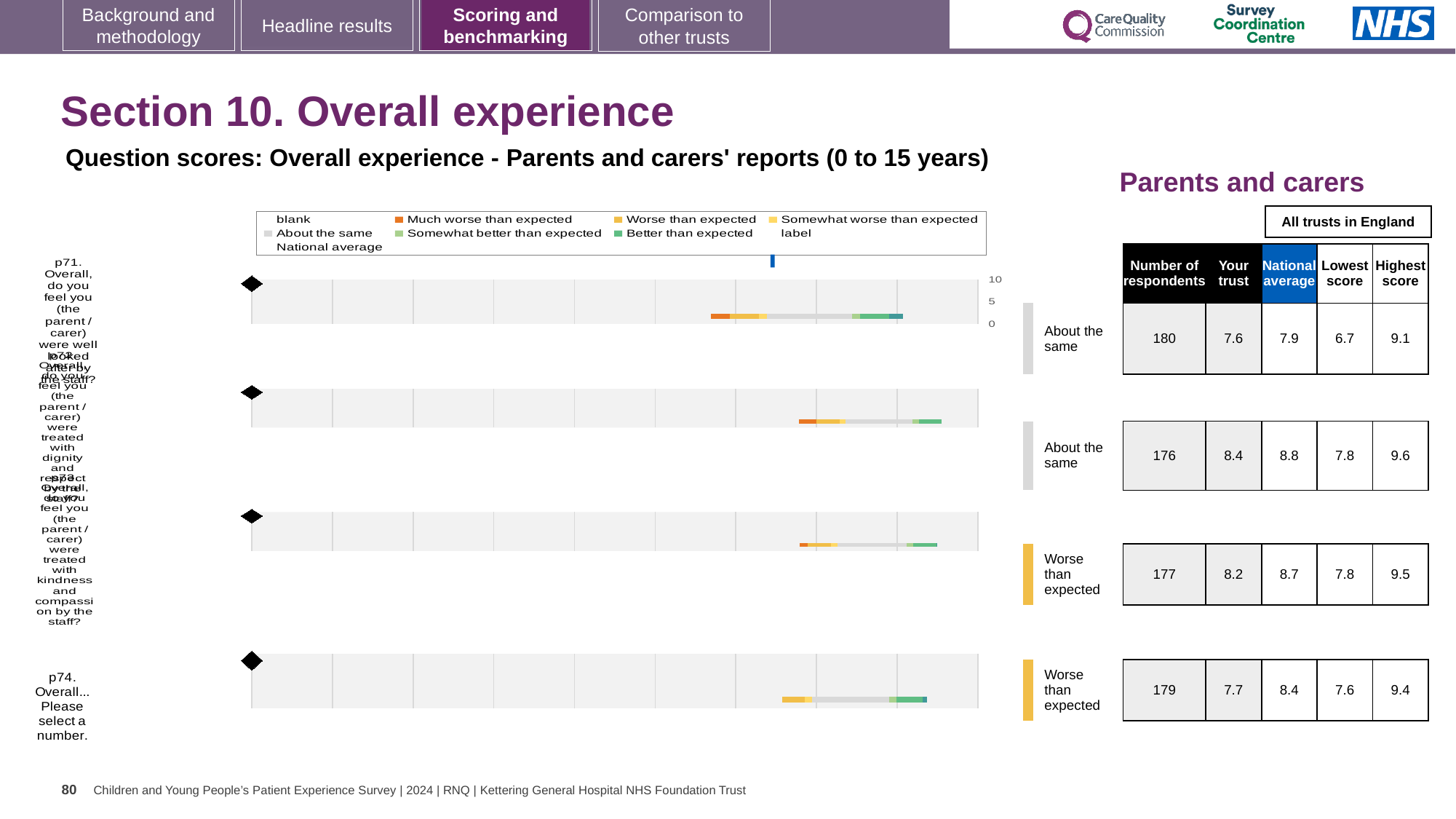
In the table beside the chart, which is larger for p72: the 'Your trust' score or the national average? National average In the table beside the chart, what is the 'Your trust' score for p71 (overall, were you well looked after by the staff)? 7.6 In the table beside the chart, which question has the lowest 'Your trust' score? p71 How many entries does the chart legend list? 9 In the table beside the chart, what is the difference between the national average and the 'Your trust' score for p74? 0.7 What colour does the legend use for 'Much worse than expected'? orange What kind of chart is shown on the slide? bar chart In the table beside the chart, which question has the highest 'Your trust' score? p72 How many question bars (p71 to p74) are plotted in the chart? 4 What benchmark category label is shown next to the p74 bar? Worse than expected In the table beside the chart, what is the national average for p74 (Overall... Please select a number)? 8.4 What is the highest tick value shown on the chart's score axis? 10